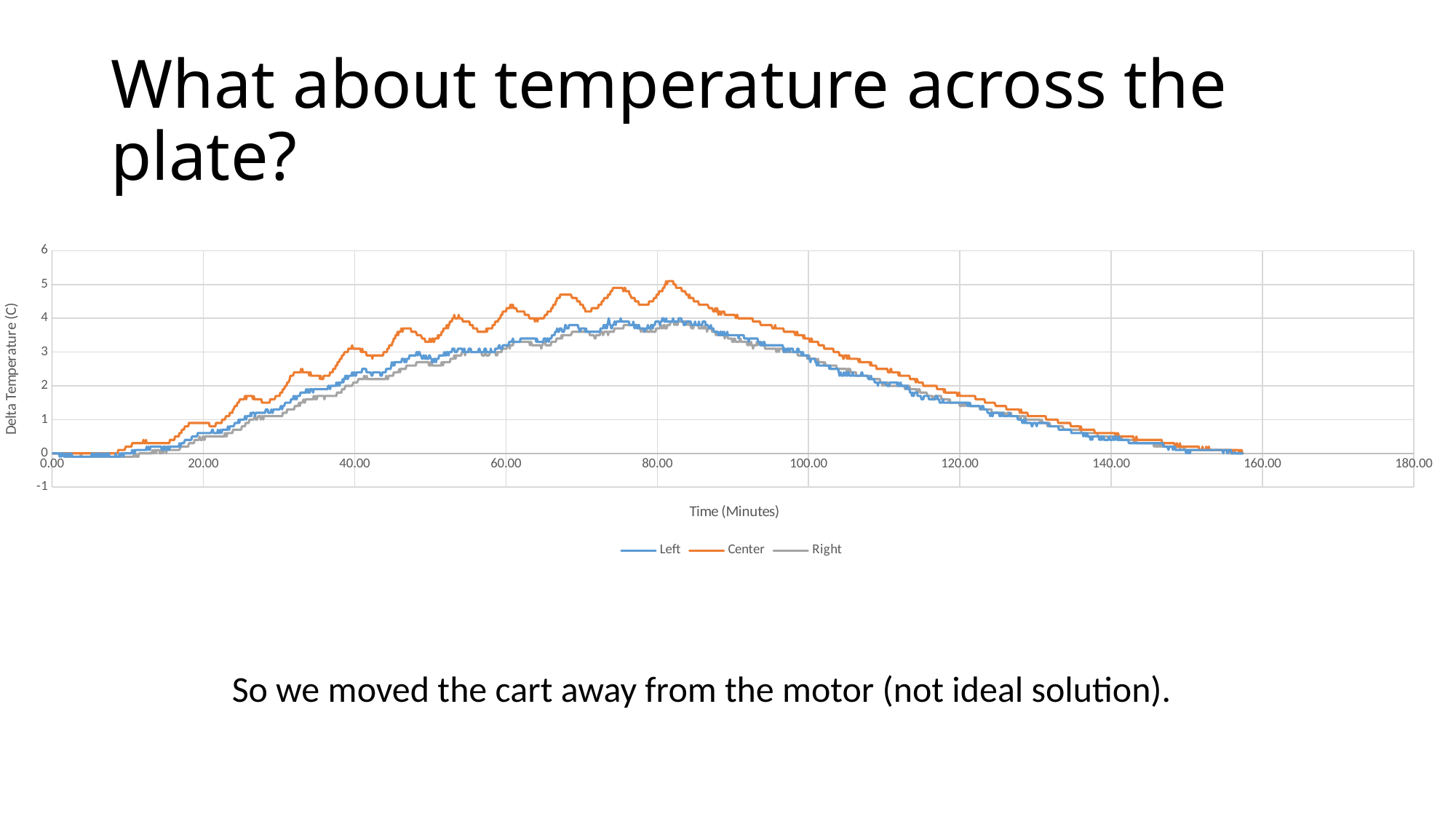
Is the Left series value at 20.00 minutes greater or less than 1? less Is the Center series value at 40.00 minutes greater or less than 2? greater Which series reaches the highest delta temperature? Center At 60.00 minutes, which series has the larger value, Center or Right? Center Is the Center series value at 80.00 minutes greater or less than 4? greater How do the delta temperature values change over time from 0 to about 160 minutes? They rise to a peak around 80 minutes and then fall What is the label of the vertical axis? Delta Temperature (C) How many series does the legend list? 3 What are the series names listed in the legend? Left, Center, Right What kind of chart is shown on the slide? line chart